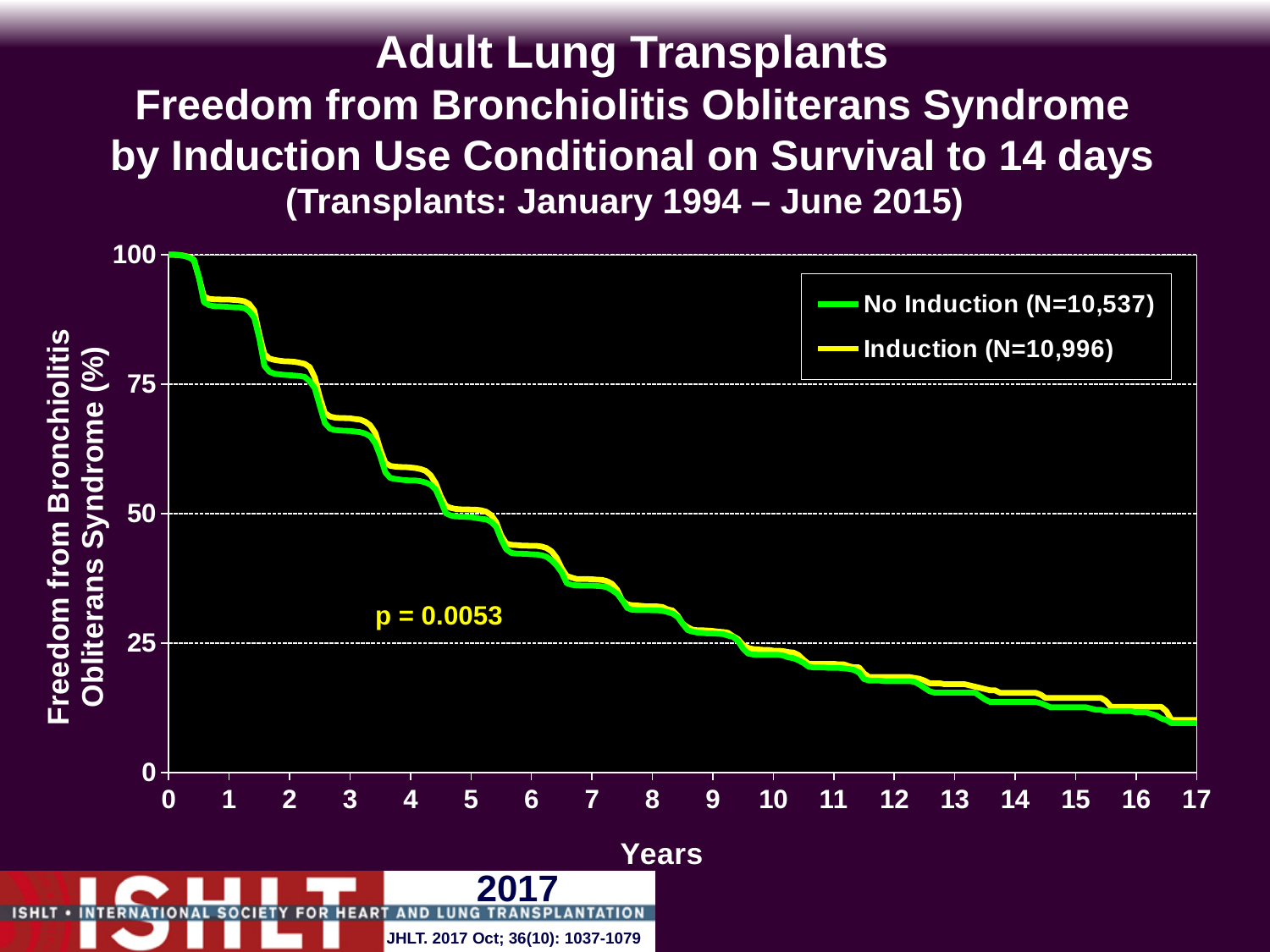
What kind of chart is shown on the slide? line chart What is the N for the Induction group shown in the legend? 10,996 What p-value is printed on the chart? p = 0.0053 Is the value for the Induction curve at year 1 greater or less than 75? greater What is the value of both curves at year 0? 100 What is the N for the No Induction group shown in the legend? 10,537 Is the value for the No Induction curve at year 10 greater or less than 25? less How many series does the legend list? 2 What is the label of the x axis? Years Do the curves rise or fall as years increase along the x axis? fall Is the value for the No Induction curve at year 7 greater or less than 50? less